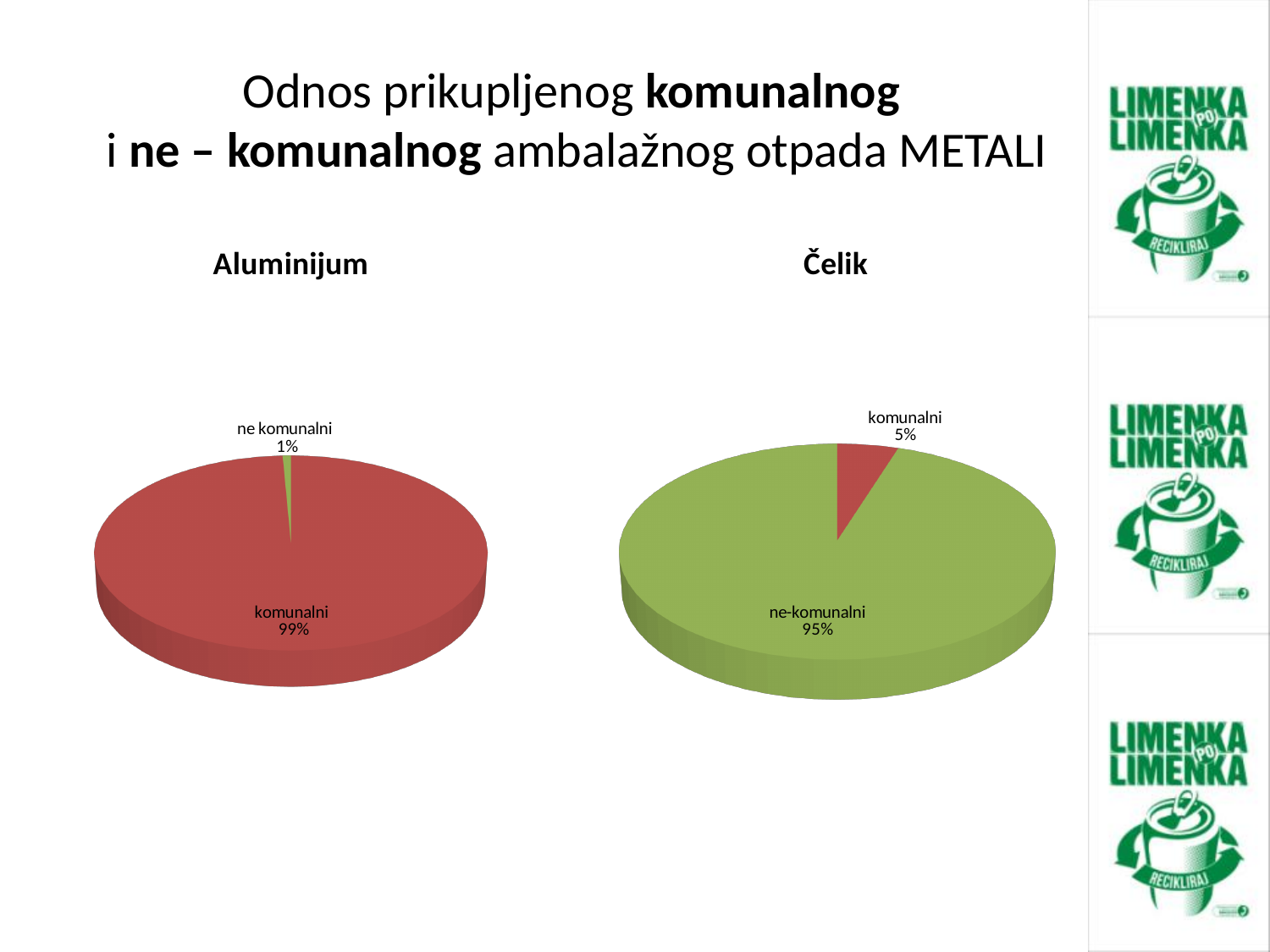
In the Čelik chart, which slice is the smallest? komunalni In the Čelik chart, what share does ne-komunalni have? 95% In the Čelik chart, what share does komunalni have? 5% Which is larger: the komunalni share in the Aluminijum chart or the komunalni share in the Čelik chart? Aluminijum In the Aluminijum chart, which slice is the largest? komunalni In the Aluminijum chart, what is the difference between the komunalni and ne komunalni shares? 98% In the Aluminijum chart, what share does ne komunalni have? 1% In the Aluminijum chart, what share does komunalni have? 99% What is the title of the chart on the right? Čelik How many slices does the Čelik chart have? 2 In the Čelik chart, what is the difference between the ne-komunalni and komunalni shares? 90% What kind of chart is the Aluminijum chart? Pie chart